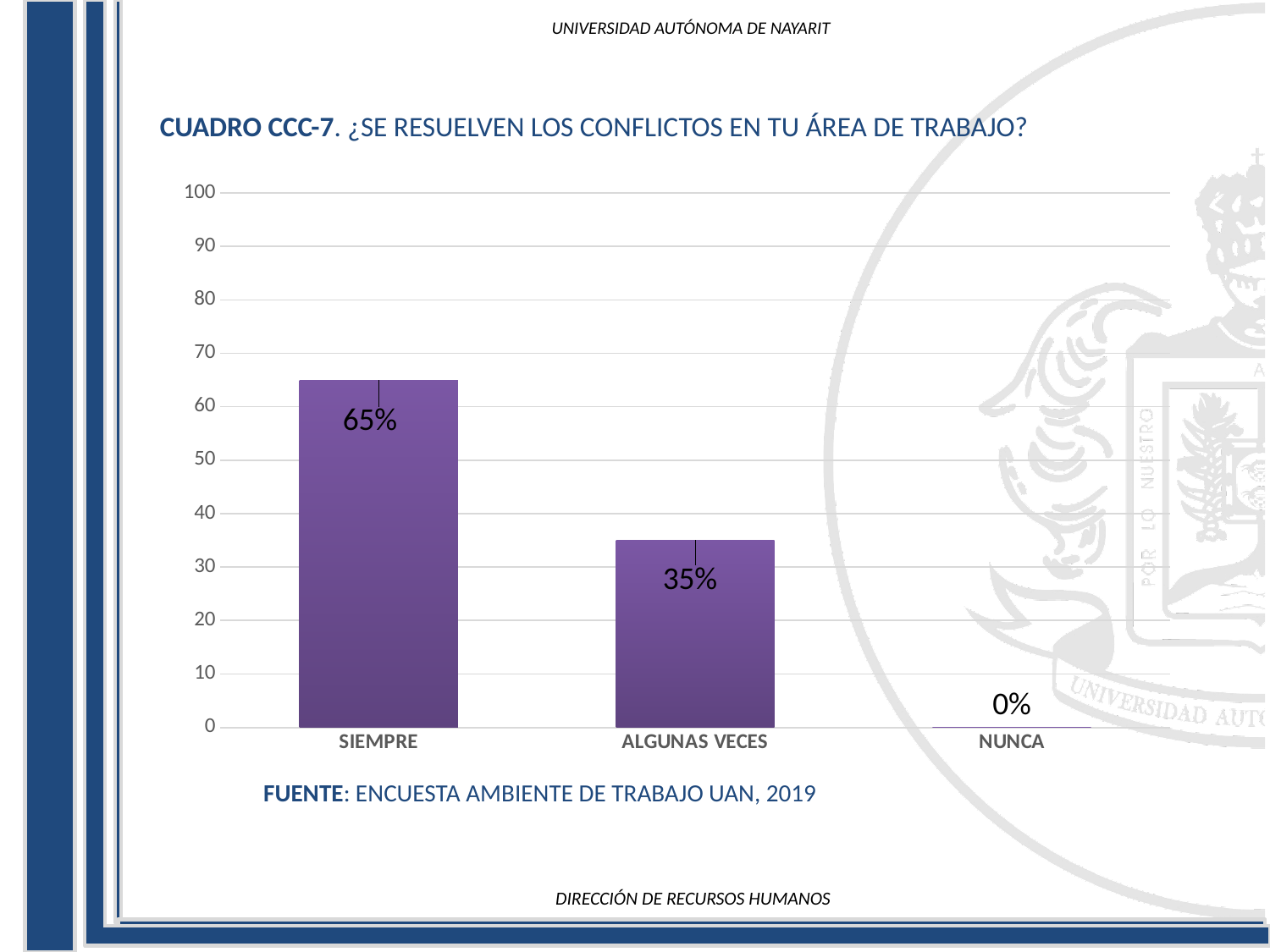
What source is cited below the chart? ENCUESTA AMBIENTE DE TRABAJO UAN, 2019 How many categories are shown on the x axis? 3 Is the value for ALGUNAS VECES greater or less than 40? less What is the value for NUNCA? 0% Which is larger, the value for SIEMPRE or the value for ALGUNAS VECES? SIEMPRE What is the value for ALGUNAS VECES? 35% Which category has the lowest value? NUNCA What is the difference between the values for SIEMPRE and ALGUNAS VECES? 30% What is the value for SIEMPRE? 65% Is the value for SIEMPRE greater or less than 60? greater What kind of chart is shown on the slide? bar chart Which category has the highest value? SIEMPRE